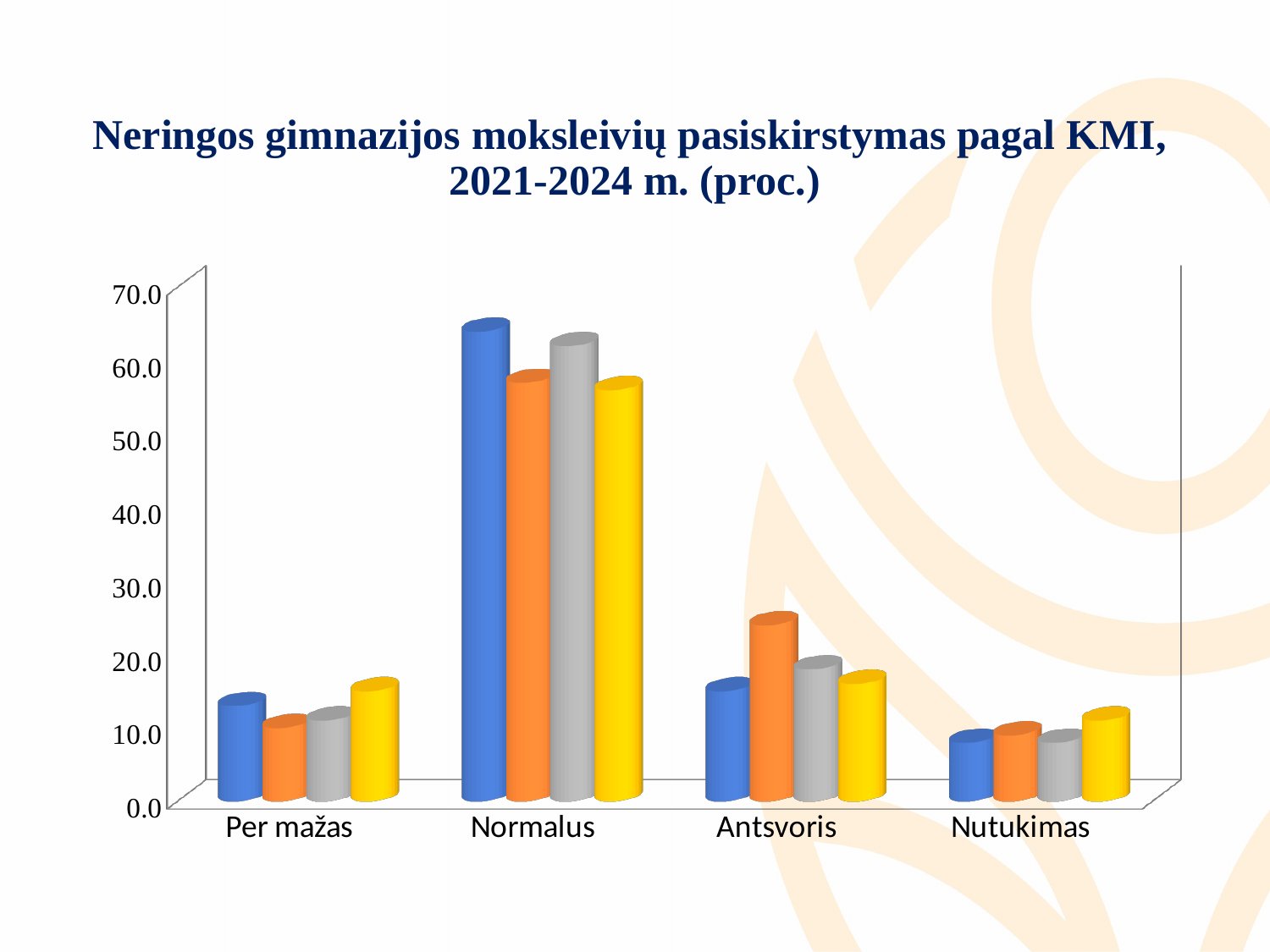
Which category has the lowest values? Nutukimas How many bars are plotted for each category? 4 What is the title of the chart? Neringos gimnazijos moksleivių pasiskirstymas pagal KMI, 2021-2024 m. (proc.) Is the value of the orange bar for Antsvoris greater or less than 20.0? greater What kind of chart is shown on the slide? bar chart Is the value of the blue bar for Normalus greater or less than 60.0? greater Which category has the highest values? Normalus Is the value of the blue bar for Nutukimas greater or less than 10.0? less How many categories are shown on the x axis? 4 Which bar is tallest within the Antsvoris category: the blue one or the orange one? the orange one Which is larger: the blue bar for Normalus or the blue bar for Antsvoris? the blue bar for Normalus